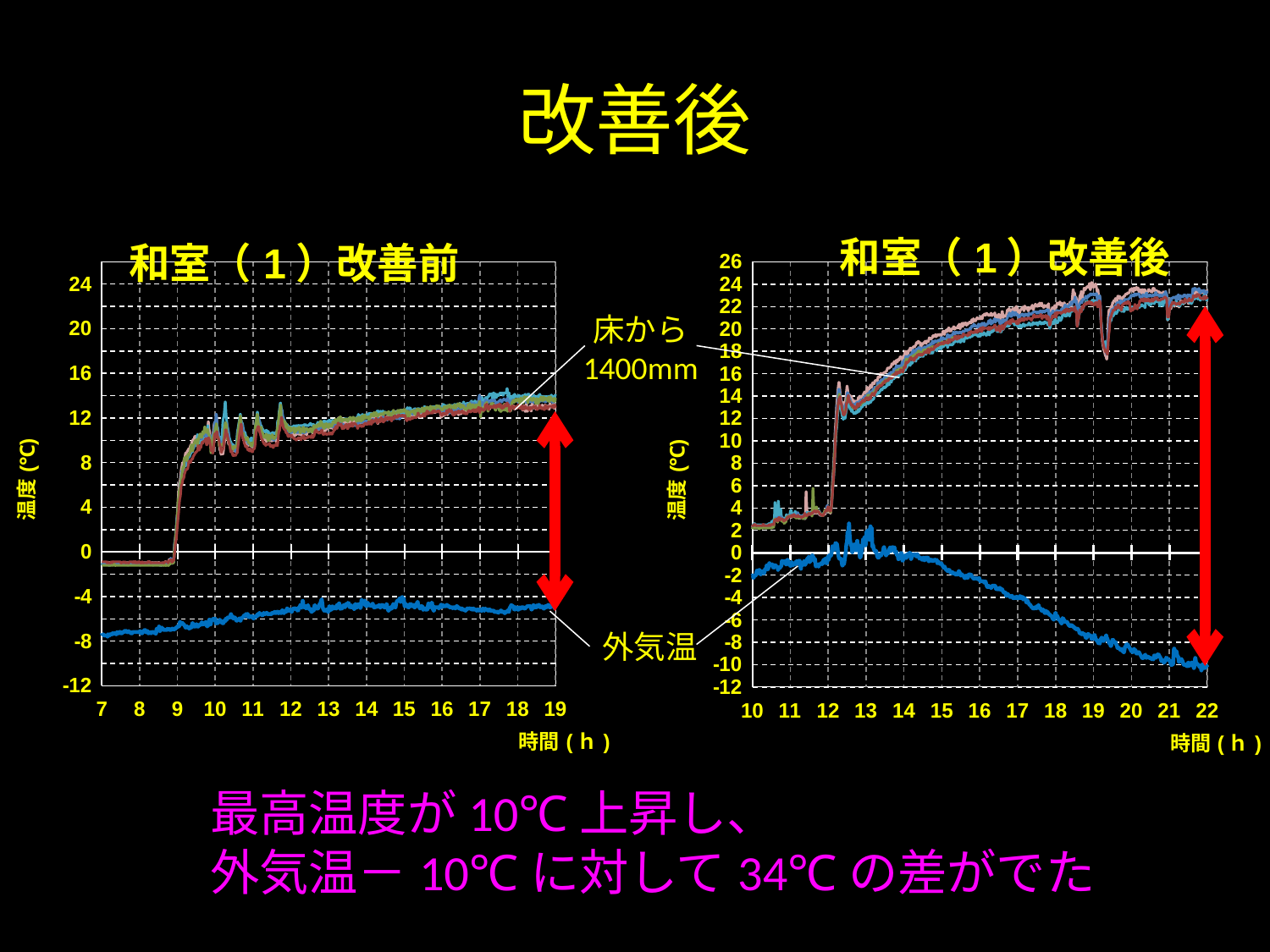
In the right chart (和室（1）改善後), is the indoor temperature (床から1400mm) at 22 h greater or less than 20? greater In the left chart (和室（1）改善前), is the indoor temperature (床から1400mm) at 19 h greater or less than 16? less What kind of chart is the right chart titled 和室（1）改善後? line chart In the left chart (和室（1）改善前), do the indoor temperature lines (床から1400mm) rise or fall between 12 h and 19 h? rise What is the x-axis title of the left chart (和室（1）改善前)? 時間 ( h ) What is the highest value labeled on the y axis of the right chart (和室（1）改善後)? 26 What kind of chart is the left chart titled 和室（1）改善前? line chart In the right chart (和室（1）改善後), does the outdoor temperature (外気温) line rise or fall between 14 h and 22 h? fall In the right chart (和室（1）改善後), is the indoor temperature (床から1400mm) at 10 h greater or less than 6? less In the right chart (和室（1）改善後), at 22 h, which is larger: the indoor temperature (床から1400mm) or the outdoor temperature (外気温)? indoor temperature (床から1400mm)